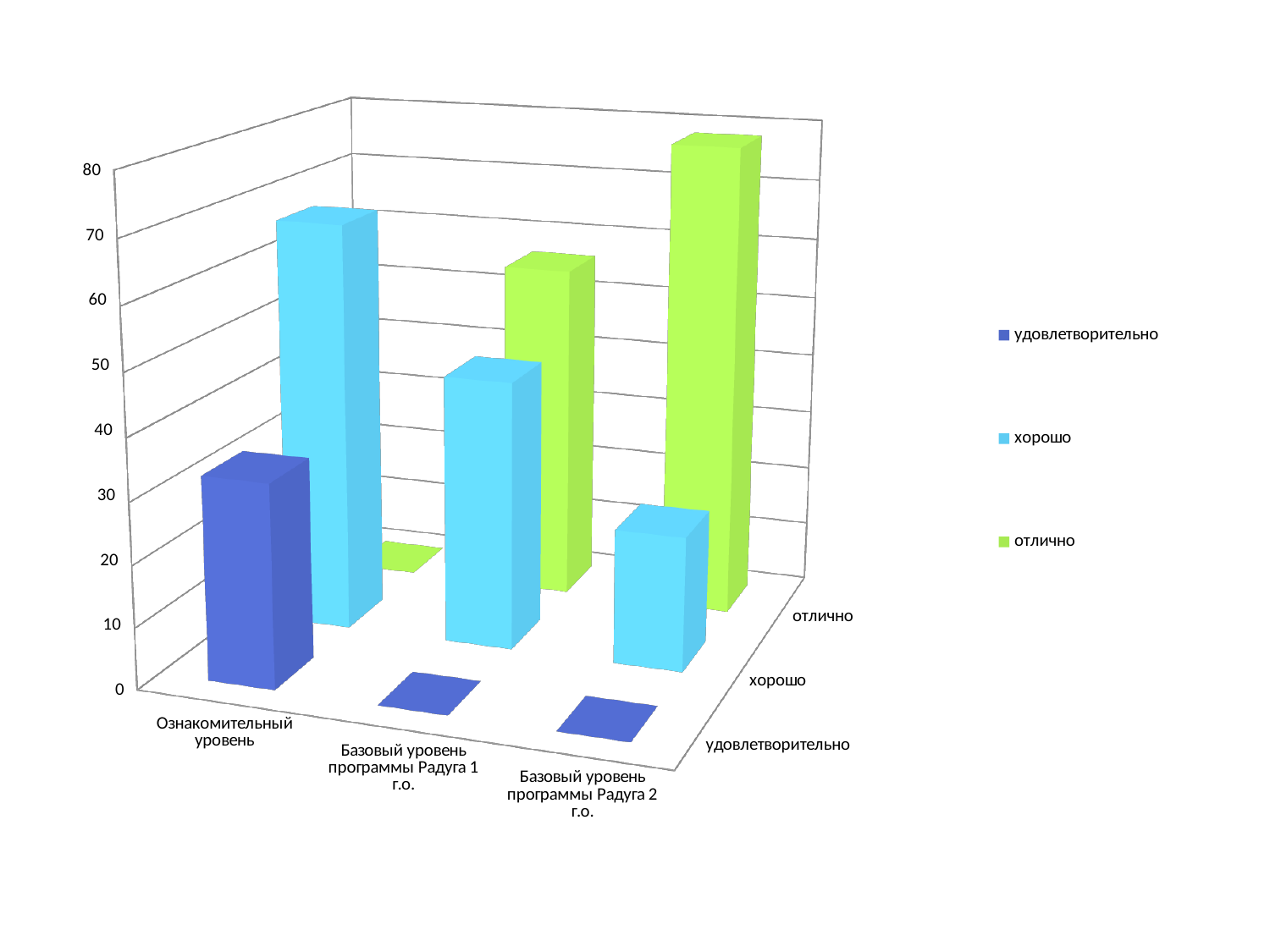
Which series has the tallest bar for Базовый уровень программы Радуга 2 г.о.? отлично Is the value of удовлетворительно for Ознакомительный уровень greater or less than 50? less Which category has the larger value for отлично: Ознакомительный уровень or Базовый уровень программы Радуга 2 г.о.? Базовый уровень программы Радуга 2 г.о. Is the value of хорошо for Ознакомительный уровень greater or less than 50? greater Which category has the tallest bar in the chart? Базовый уровень программы Радуга 2 г.о. How many categories are shown along the x axis of the chart? 3 Is the value of отлично for Базовый уровень программы Радуга 2 г.о. greater or less than 50? greater What kind of chart is shown on the slide? bar chart Which series is shown in green in the chart? отлично For Ознакомительный уровень, which is larger: хорошо or удовлетворительно? хорошо How many series does the chart's legend list? 3 What are the three legend entries of the chart? удовлетворительно, хорошо, отлично